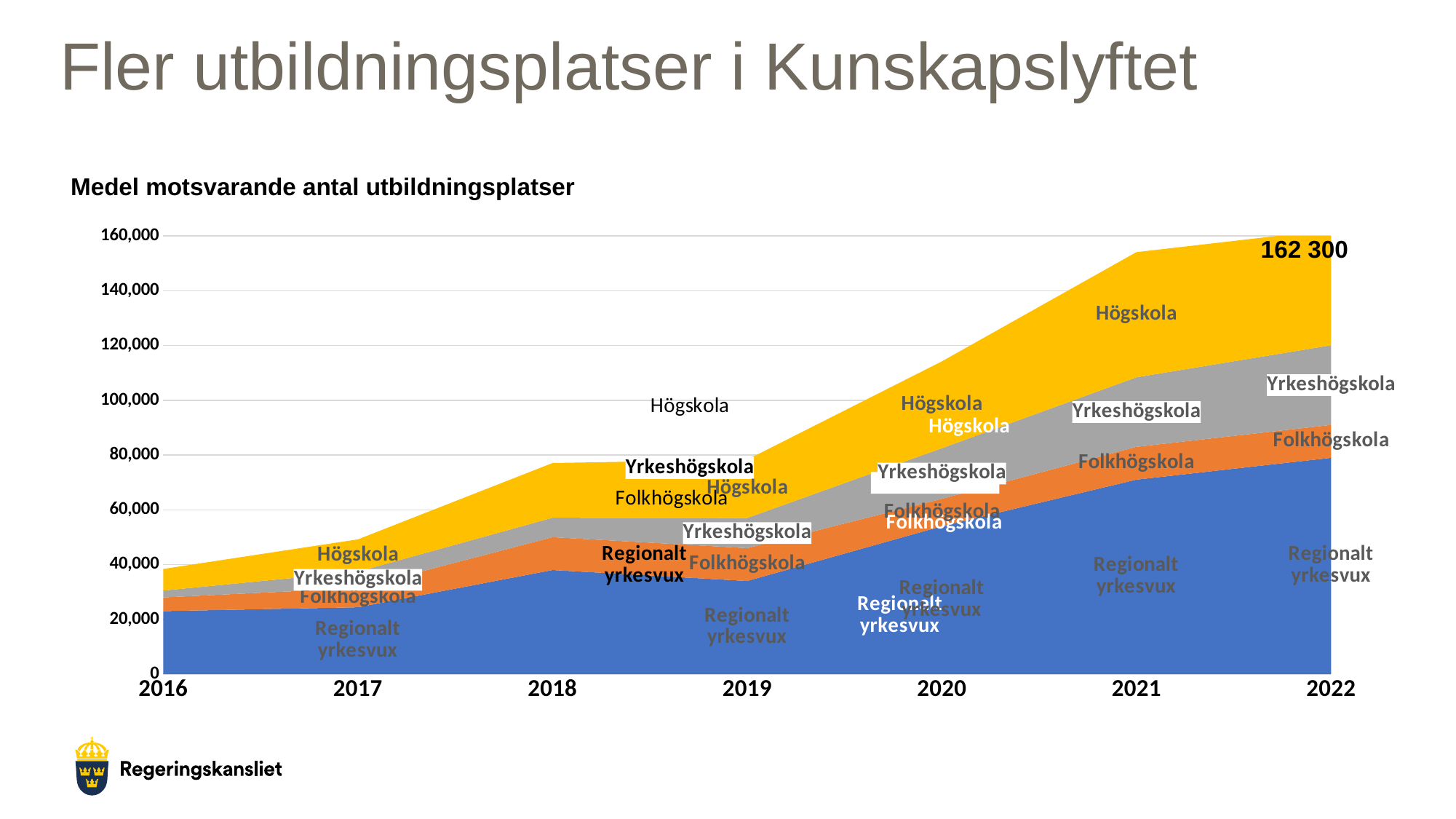
Is the value for Regionalt yrkesvux in 2022 greater or less than 60,000? greater Is the total value for 2021 greater or less than 140,000? greater Which year has the highest total number of utbildningsplatser? 2022 What is the total number of utbildningsplatser shown for 2022? 162 300 Does the total number of utbildningsplatser rise or fall from 2016 to 2022? Rise Is the total value for 2017 greater or less than 40,000? greater Which year has the lowest total number of utbildningsplatser? 2016 How many years are plotted along the x axis? 7 Which is larger, the total for 2021 or the total for 2018? 2021 How many series (education types) are stacked in the chart? 4 Which series is shown at the bottom of the stack in blue? Regionalt yrkesvux What kind of chart is shown on the slide? Stacked area chart